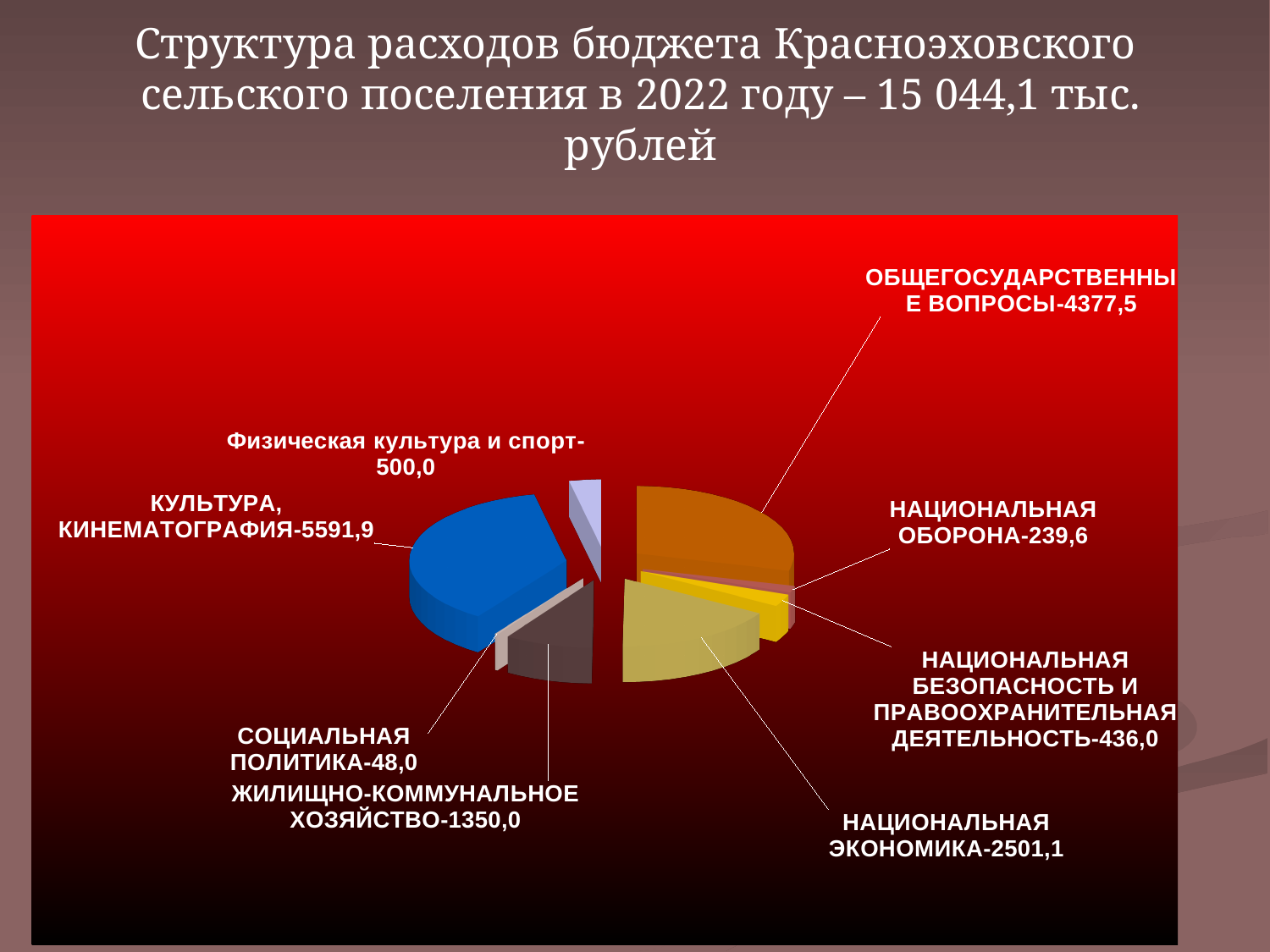
Which category has the largest value in the pie chart? КУЛЬТУРА, КИНЕМАТОГРАФИЯ How many categories (slices) does the pie chart show? 8 Which is larger: НАЦИОНАЛЬНАЯ БЕЗОПАСНОСТЬ И ПРАВООХРАНИТЕЛЬНАЯ ДЕЯТЕЛЬНОСТЬ or НАЦИОНАЛЬНАЯ ОБОРОНА? НАЦИОНАЛЬНАЯ БЕЗОПАСНОСТЬ И ПРАВООХРАНИТЕЛЬНАЯ ДЕЯТЕЛЬНОСТЬ What is the value for ЖИЛИЩНО-КОММУНАЛЬНОЕ ХОЗЯЙСТВО? 1350,0 What is the difference between НАЦИОНАЛЬНАЯ ЭКОНОМИКА and ЖИЛИЩНО-КОММУНАЛЬНОЕ ХОЗЯЙСТВО? 1151,1 What is the value for НАЦИОНАЛЬНАЯ ОБОРОНА? 239,6 Which category has the smallest value in the pie chart? СОЦИАЛЬНАЯ ПОЛИТИКА What is the value for КУЛЬТУРА, КИНЕМАТОГРАФИЯ? 5591,9 What total budget expenditure amount is stated in the slide title? 15 044,1 тыс. рублей What is the value for ОБЩЕГОСУДАРСТВЕННЫЕ ВОПРОСЫ? 4377,5 What type of chart is shown on the slide? Pie chart What is the difference between КУЛЬТУРА, КИНЕМАТОГРАФИЯ and ОБЩЕГОСУДАРСТВЕННЫЕ ВОПРОСЫ? 1214,4